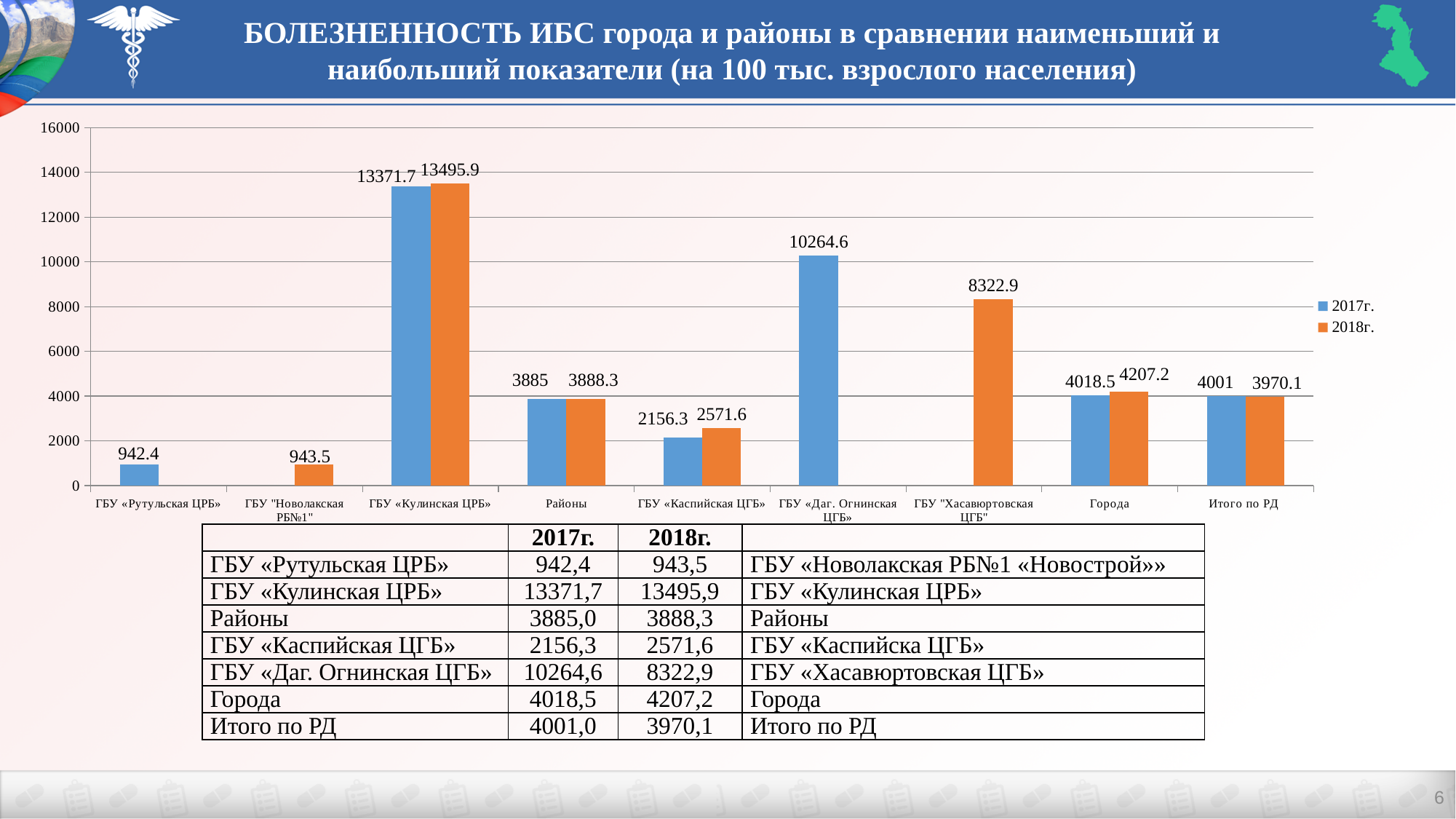
For Города, which year has the larger value, 2017г. or 2018г.? 2018г. What is the 2017г. value for Районы? 3885 How many categories are shown on the x axis of the chart? 9 What kind of chart is shown on the slide? Bar chart What is the difference between the 2018г. and 2017г. values for ГБУ «Каспийская ЦГБ»? 415.3 Which category has the highest 2017г. value? ГБУ «Кулинская ЦРБ» Which category has the lowest 2017г. value? ГБУ «Рутульская ЦРБ» What is the 2018г. value for ГБУ «Кулинская ЦРБ»? 13495.9 What is the 2018г. value for ГБУ "Хасавюртовская ЦГБ"? 8322.9 What is the 2017г. value for ГБУ «Даг. Огнинская ЦГБ»? 10264.6 How many series does the legend list? 2 What is the difference between the 2017г. and 2018г. values for Итого по РД? 30.9